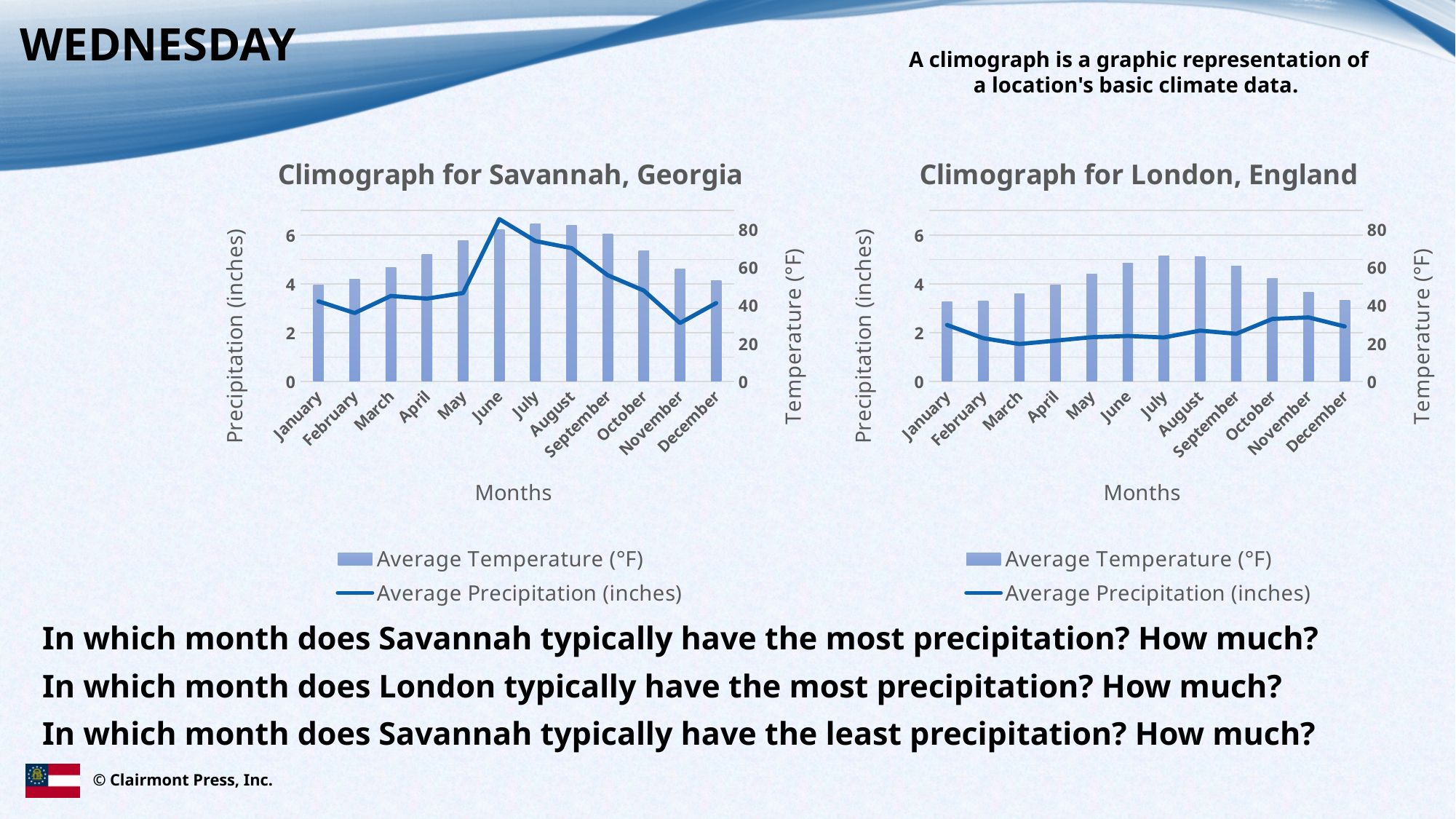
In the Climograph for Savannah, Georgia, which month has the lowest average precipitation? November In the Climograph for Savannah, Georgia, does the average temperature rise or fall from January to July? rise What kind of chart is the Climograph for Savannah, Georgia? Combined bar and line chart Which series is shown as a line in the Climograph for London, England? Average Precipitation (inches) In the Climograph for London, England, is the average temperature for July greater or less than 60°F? greater Which is larger: the average precipitation for June in the Climograph for Savannah, Georgia, or the average precipitation for June in the Climograph for London, England? Savannah, Georgia In the Climograph for Savannah, Georgia, is the average temperature for January greater or less than 60°F? less In the Climograph for Savannah, Georgia, is the average precipitation for June greater or less than 6 inches? greater In the Climograph for London, England, which month has the lowest average precipitation? March In the Climograph for Savannah, Georgia, which month has the highest average precipitation? June How many series does the legend list for the Climograph for London, England? 2 How many months are shown on the x axis of the Climograph for Savannah, Georgia? 12